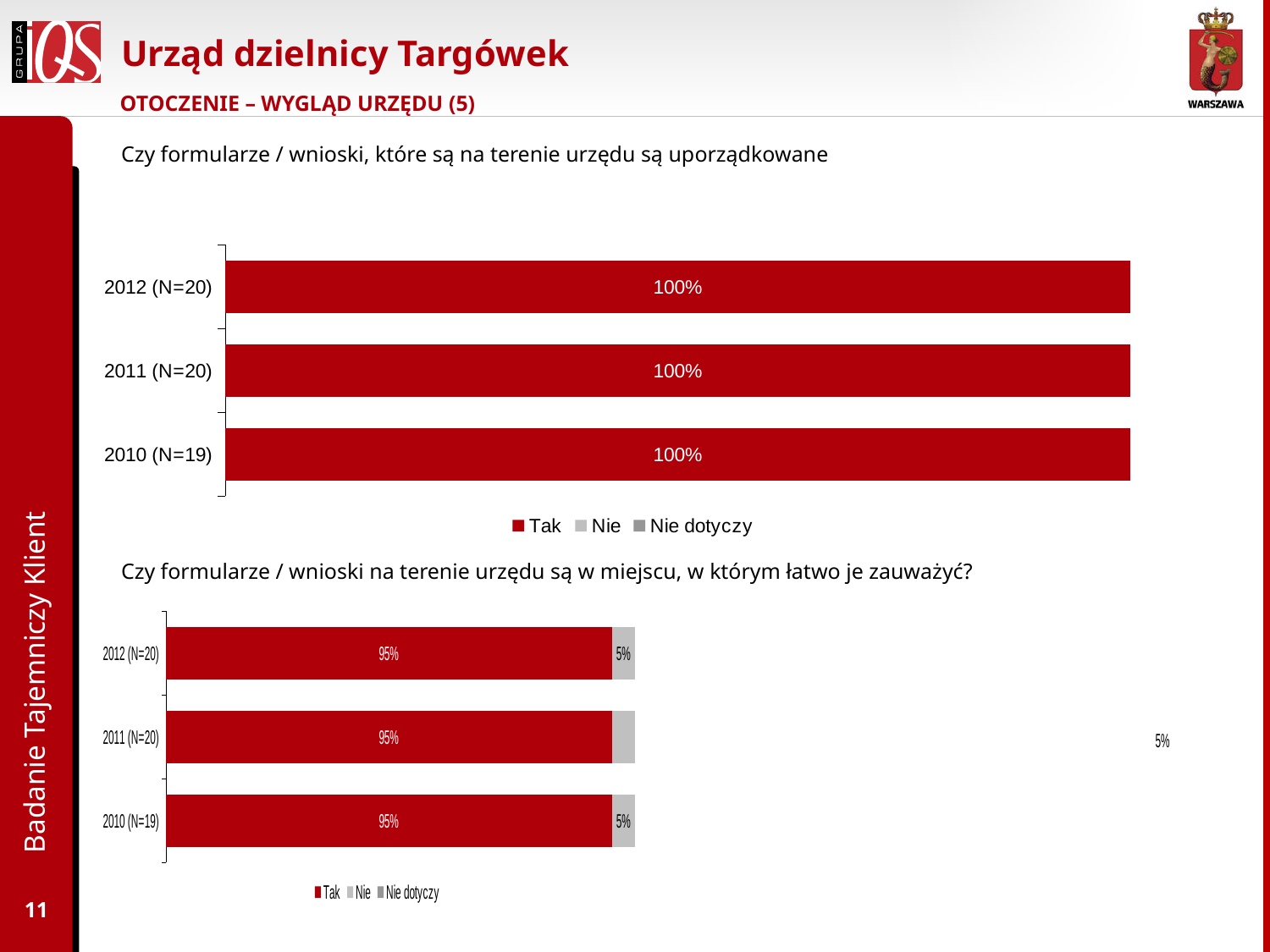
In the top chart ("Czy formularze / wnioski, które są na terenie urzędu są uporządkowane"), how many series does the legend list? 3 In the top chart ("Czy formularze / wnioski, które są na terenie urzędu są uporządkowane"), how many year categories are shown? 3 In the top chart ("Czy formularze / wnioski, które są na terenie urzędu są uporządkowane"), what is the value for 2010 (N=19)? 100% In the bottom chart ("Czy formularze / wnioski na terenie urzędu są w miejscu, w którym łatwo je zauważyć?"), what are the legend entries? Tak, Nie, Nie dotyczy In the bottom chart ("Czy formularze / wnioski na terenie urzędu są w miejscu, w którym łatwo je zauważyć?"), does the Tak value change across the years 2010 to 2012? No, it stays at 95% In the bottom chart ("Czy formularze / wnioski na terenie urzędu są w miejscu, w którym łatwo je zauważyć?"), what is the Nie value for 2010 (N=19)? 5% In the bottom chart ("Czy formularze / wnioski na terenie urzędu są w miejscu, w którym łatwo je zauważyć?"), what is the total of the 2012 (N=20) bar? 100% What kind of chart is the top chart ("Czy formularze / wnioski, które są na terenie urzędu są uporządkowane")? Bar chart In the bottom chart ("Czy formularze / wnioski na terenie urzędu są w miejscu, w którym łatwo je zauważyć?"), what is the difference between the Tak and Nie values for 2012 (N=20)? 90% In the top chart ("Czy formularze / wnioski, które są na terenie urzędu są uporządkowane"), what is the value for 2012 (N=20)? 100% In the bottom chart ("Czy formularze / wnioski na terenie urzędu są w miejscu, w którym łatwo je zauważyć?"), what is the Tak value for 2012 (N=20)? 95% In the bottom chart ("Czy formularze / wnioski na terenie urzędu są w miejscu, w którym łatwo je zauważyć?"), which is larger for 2010 (N=19): Tak or Nie? Tak